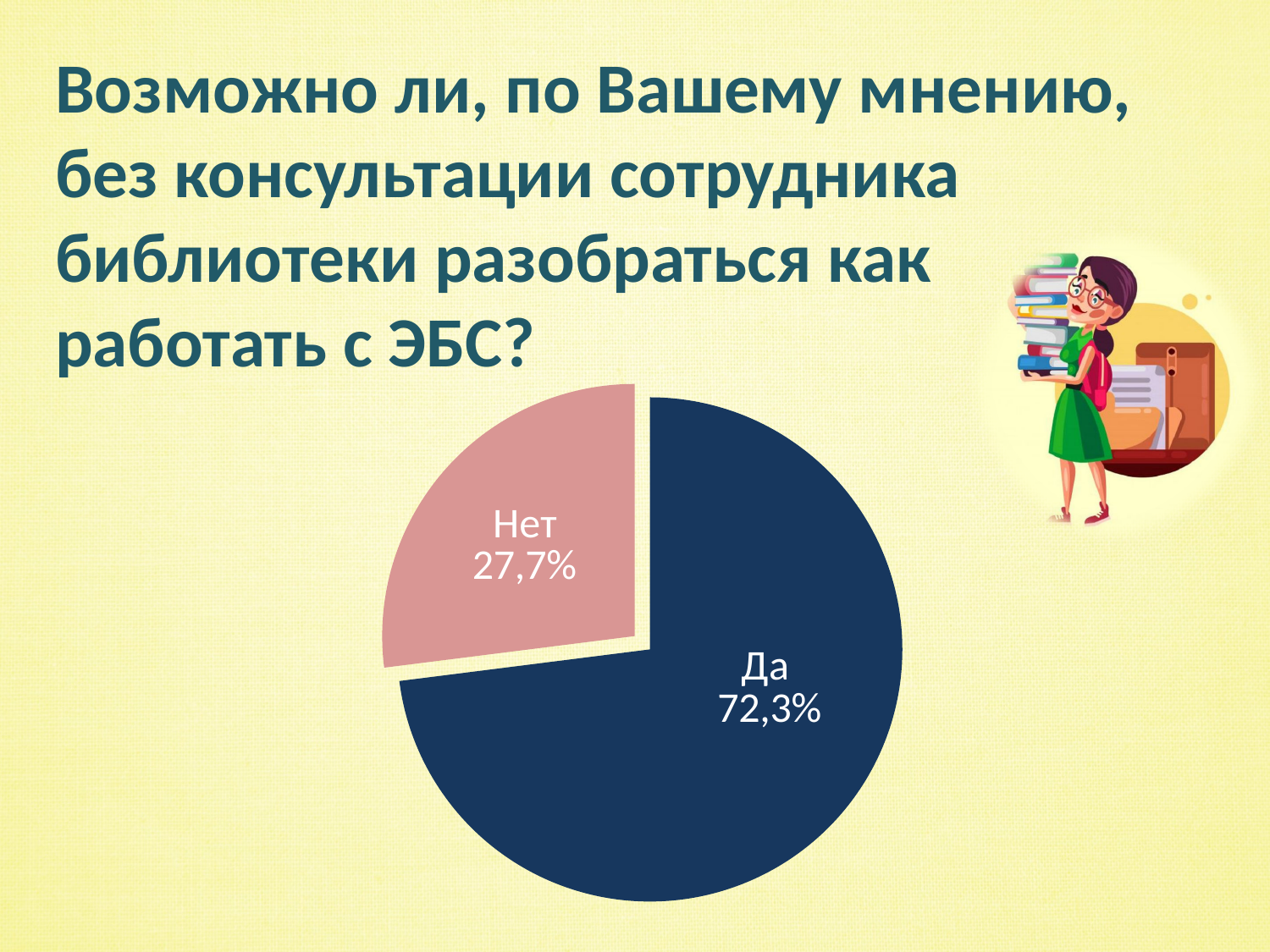
What colour is the "Да" slice of the pie? dark blue Is the share for "Да" greater or less than 50%? greater Which answer has the largest share of the pie? Да What kind of chart is shown on the slide? pie chart Which is larger, the share for "Да" or the share for "Нет"? Да What share of respondents answered "Нет"? 27,7% What colour is the "Нет" slice of the pie? pink Which answer has the smallest share of the pie? Нет Is the share for "Нет" greater or less than 50%? less What share of respondents answered "Да"? 72,3% How many slices does the pie chart have? 2 What is the difference in percentage points between the "Да" and "Нет" shares? 44,6